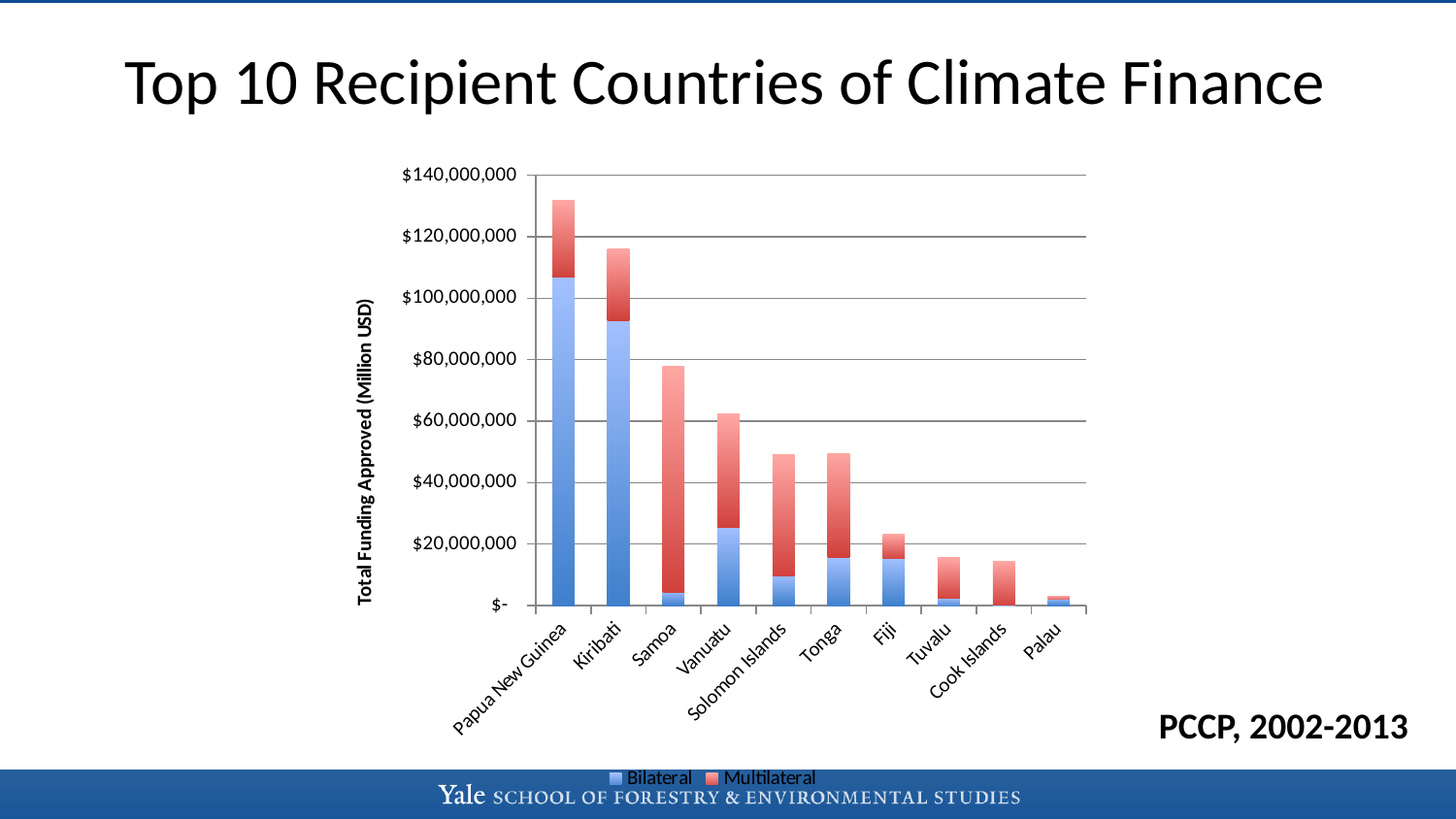
Which country has the highest total funding approved in the chart? Papua New Guinea Which country has a larger total bar, Samoa or Vanuatu? Samoa How many series does the chart's legend list? 2 Is the total value for Kiribati greater or less than $100,000,000? greater Is the total value for Papua New Guinea greater or less than $120,000,000? greater What is the title of the chart on the slide? Top 10 Recipient Countries of Climate Finance Which country has the lowest total funding approved in the chart? Palau What type of chart is shown on the slide? Stacked bar chart Do the total bar heights rise or fall moving from left to right along the x axis? Fall What are the two series named in the chart's legend? Bilateral and Multilateral Is the total value for Fiji greater or less than $40,000,000? less How many countries are shown on the x axis of the chart? 10